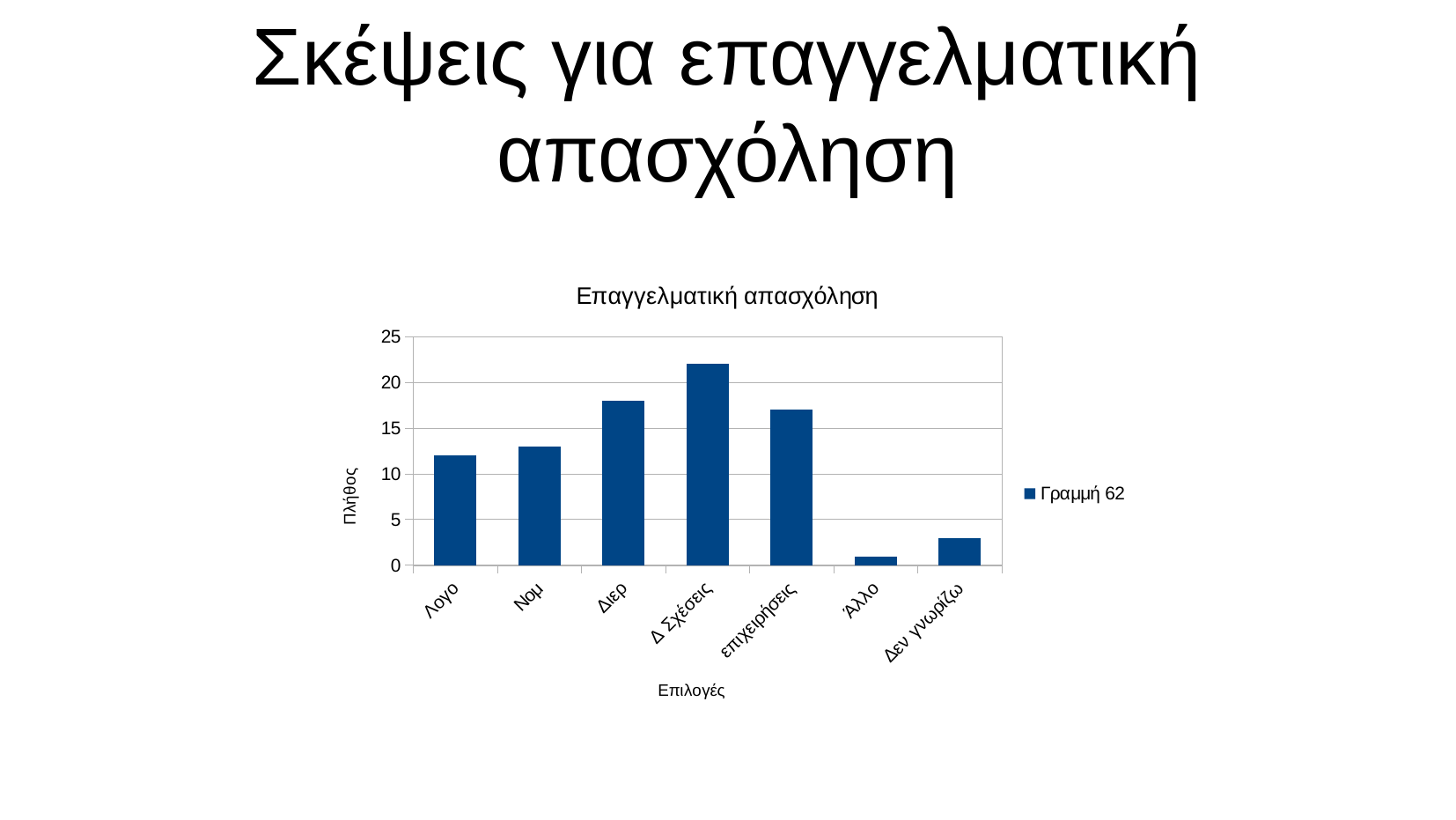
Which is larger, the value for Διερ or the value for Νομ? Διερ How many series does the chart legend list? 1 Which category has the highest value in the chart? Δ Σχέσεις Which category has the lowest value in the chart? Άλλο Is the value for Λογο greater or less than 10? greater What is the name of the series shown in the chart legend? Γραμμή 62 How many categories are shown on the x axis of the chart? 7 What kind of chart is shown on the slide? bar chart What is the title of the chart? Επαγγελματική απασχόληση Is the value for Άλλο greater or less than 5? less Is the value for Δ Σχέσεις greater or less than 20? greater